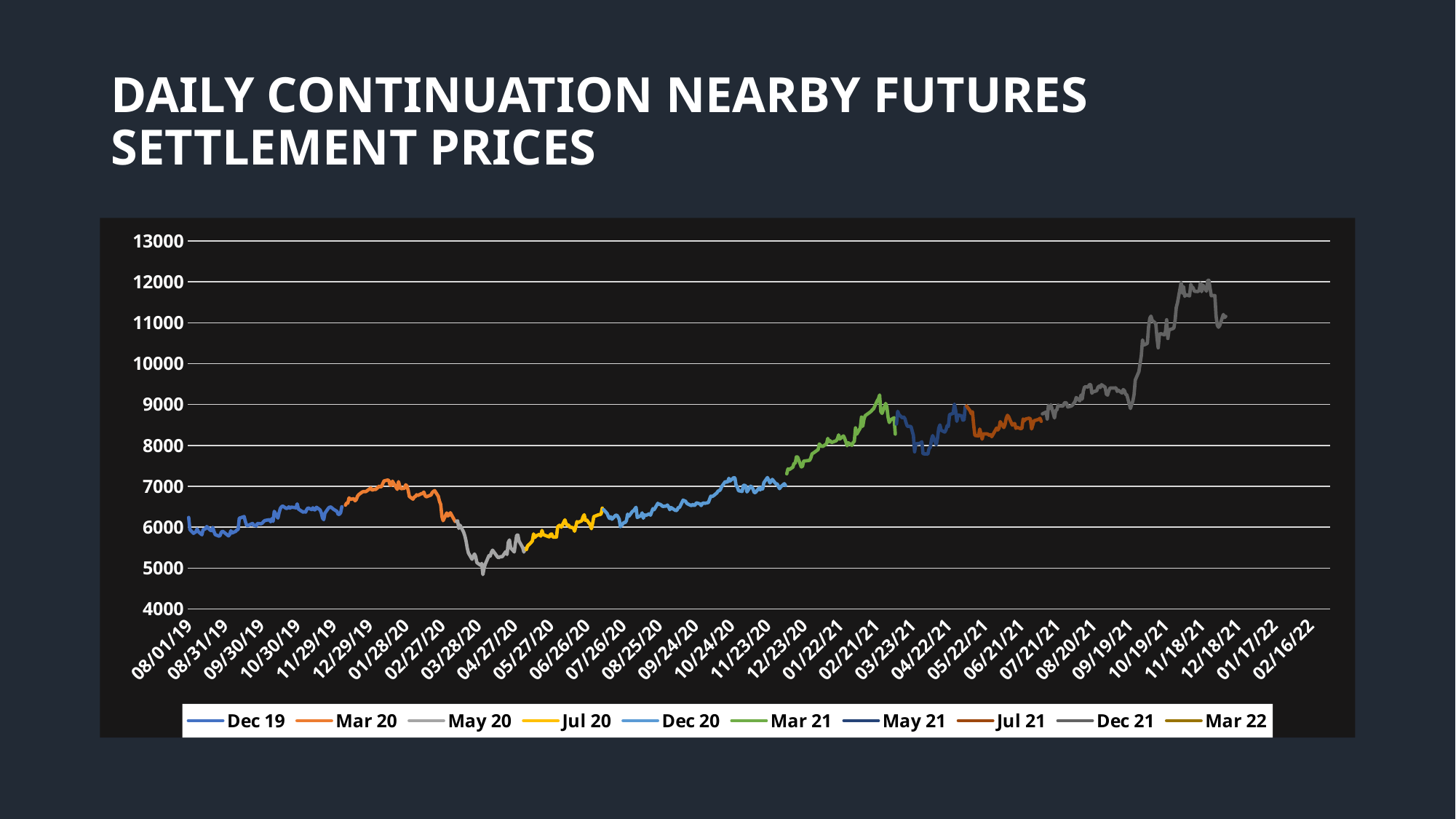
How many series does the legend list? 10 What is the highest value labelled on the y axis? 13000 What is the title of the chart? DAILY CONTINUATION NEARBY FUTURES SETTLEMENT PRICES What kind of chart is shown on the slide? line chart Which series reaches the highest values on the chart? Dec 21 Is the lowest value of the May 20 series greater or less than 6000? less Which series reaches the lowest values on the chart? May 20 Are the values of the Dec 19 series greater or less than 7000? less Overall, do the plotted prices rise or fall from left to right along the x axis? rise Is the peak value of the Dec 21 series greater or less than 11000? greater Which series has higher values, Dec 21 or Dec 19? Dec 21